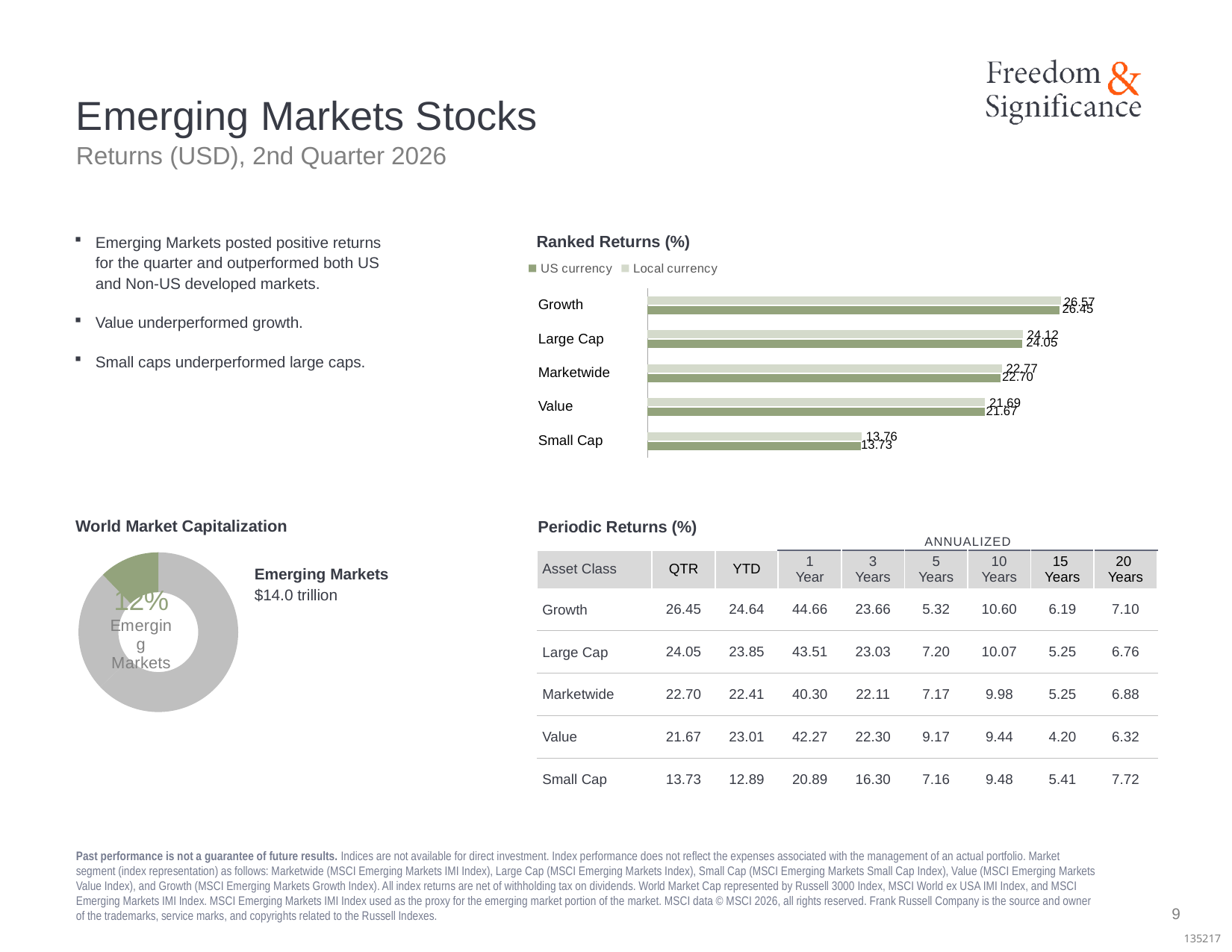
What are the two legend entries in the Ranked Returns (%) chart? US currency and Local currency In the Ranked Returns (%) chart, what is the Local currency return for Small Cap? 13.76 In the Ranked Returns (%) chart, what is the US currency return for Marketwide? 22.70 In the World Market Capitalization chart, what share of the world market do Emerging Markets represent? 12% What kind of chart is the Ranked Returns (%) chart? Bar chart How many categories are shown in the Ranked Returns (%) chart? 5 In the Ranked Returns (%) chart, which has the larger US currency return, Large Cap or Value? Large Cap In the Ranked Returns (%) chart, which category has the highest US currency return? Growth In the Ranked Returns (%) chart, what is the difference between the US currency returns for Growth and Small Cap? 12.72 In the Ranked Returns (%) chart, which category has the lowest Local currency return? Small Cap In the Ranked Returns (%) chart, what is the US currency return for Growth? 26.45 How many series does the legend of the Ranked Returns (%) chart list? 2